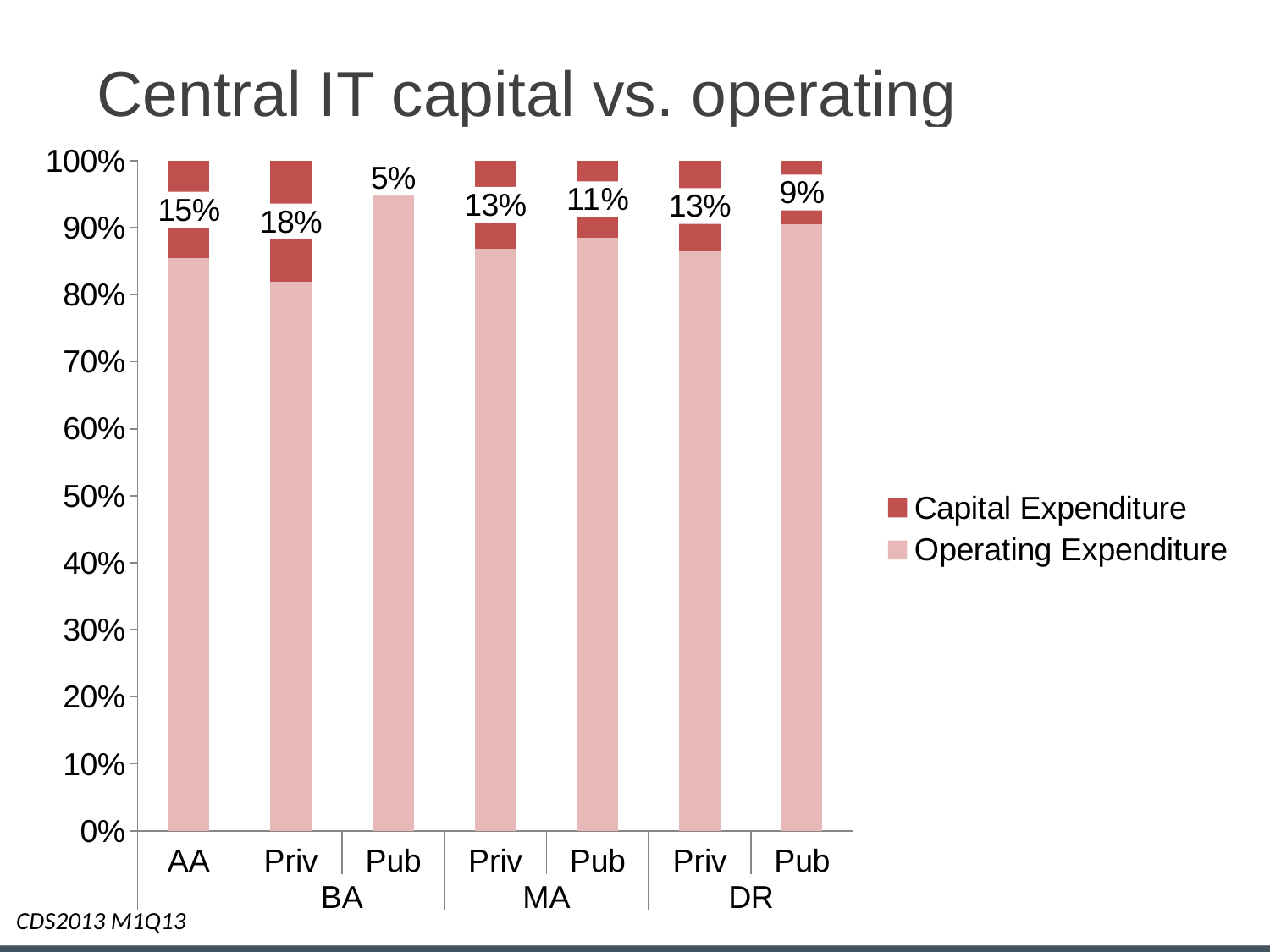
Which category has the lowest Capital Expenditure share? BA Pub What is the Capital Expenditure share for MA Pub? 11% What is the Capital Expenditure share for BA Priv? 18% Which category has the highest Capital Expenditure share? BA Priv Which has a larger Capital Expenditure share, MA Priv or MA Pub? MA Priv Is the Operating Expenditure share for BA Pub greater or less than 90%? greater How many series does the legend list? 2 How many bars are shown in the chart? 7 What is the difference in Capital Expenditure share between BA Priv and BA Pub? 13% What is the Capital Expenditure share for AA? 15% What is the Capital Expenditure share for DR Pub? 9% What type of chart is shown on the slide? Stacked bar chart